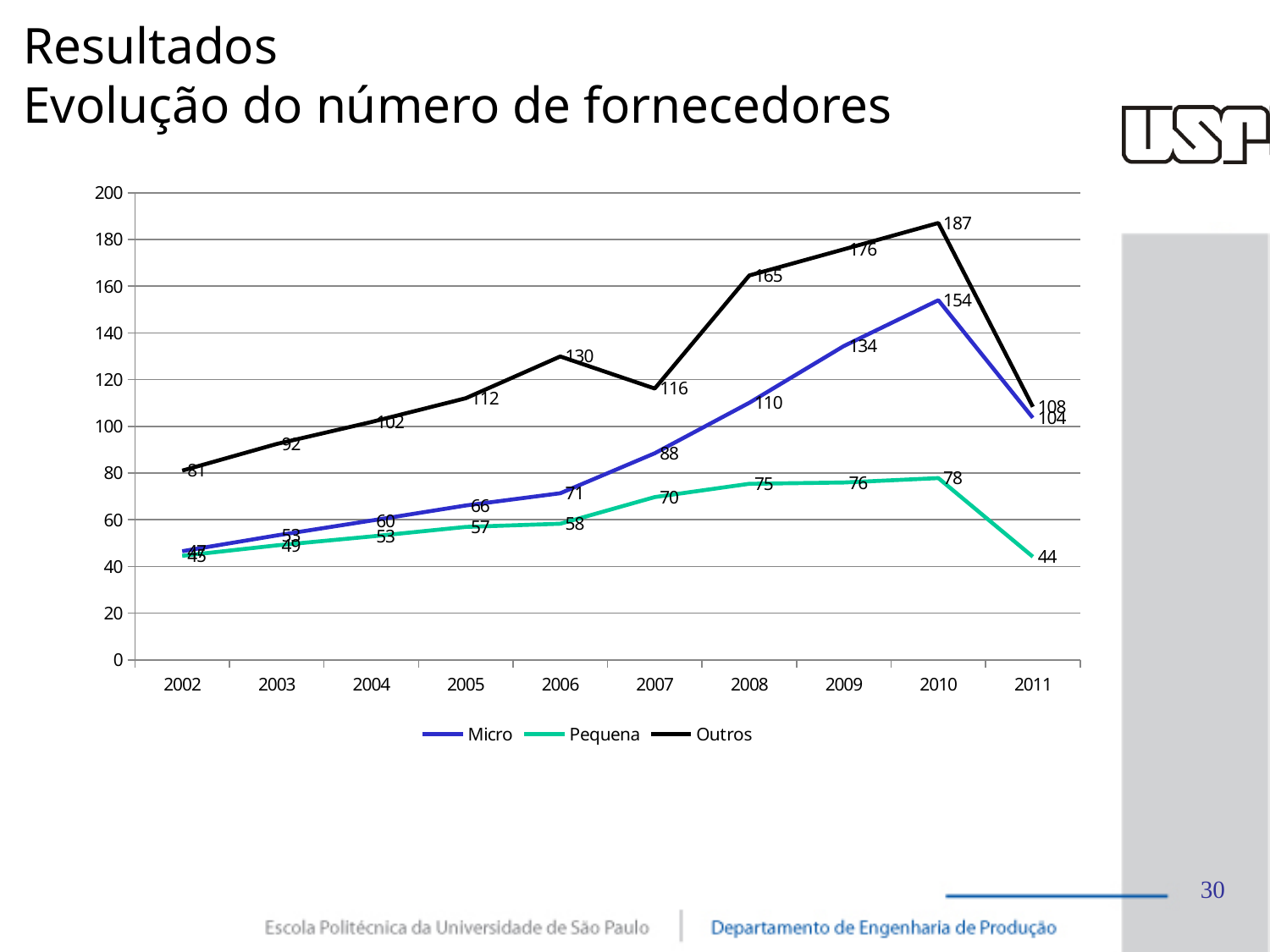
In which year does the Pequena series have its lowest value? 2011 Which series is drawn in black? Outros How many years are shown on the x axis? 10 Which is larger in 2008, Micro or Pequena? Micro Does the Outros series rise or fall from 2002 to 2006? rise What is the value for Outros in 2010? 187 How many series does the legend list? 3 In which year does the Outros series reach its highest value? 2010 What is the value for Pequena in 2011? 44 What is the value for Micro in 2009? 134 What kind of chart is shown on the slide? line chart What is the difference between Outros and Micro in 2010? 33